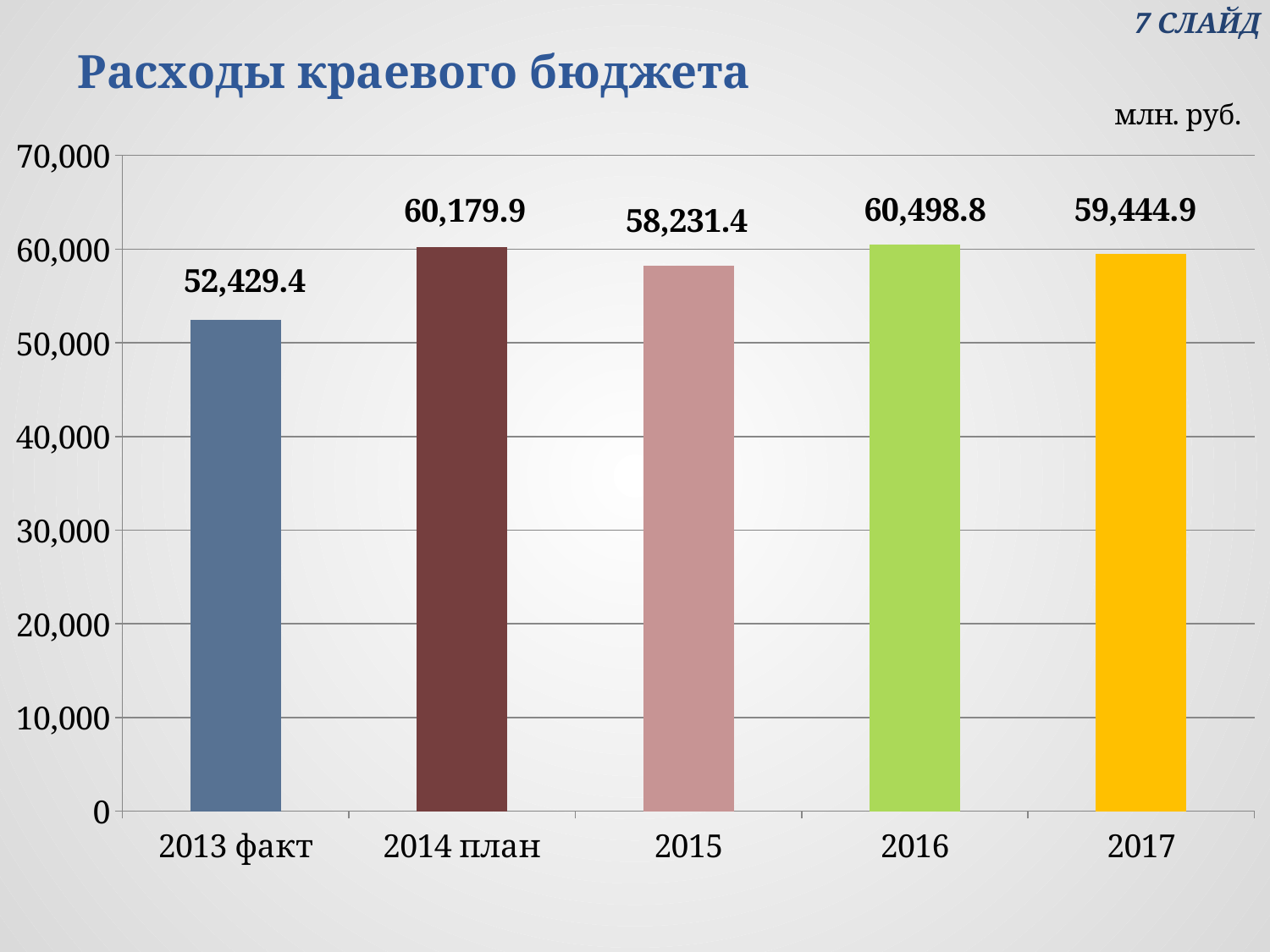
Which category has the lowest value? 2013 факт What is the value for 2017? 59,444.9 What is the difference between the values for 2016 and 2013 факт? 8,069.4 Which category has the highest value? 2016 Is the value for 2013 факт greater or less than 60,000? less How many categories are shown on the x axis? 5 What is the value for 2015? 58,231.4 What is the value for 2014 план? 60,179.9 What is the value for 2013 факт? 52,429.4 Which is larger, the value for 2015 or the value for 2017? 2017 What is the title of the chart? Расходы краевого бюджета What kind of chart is shown on the slide? bar chart